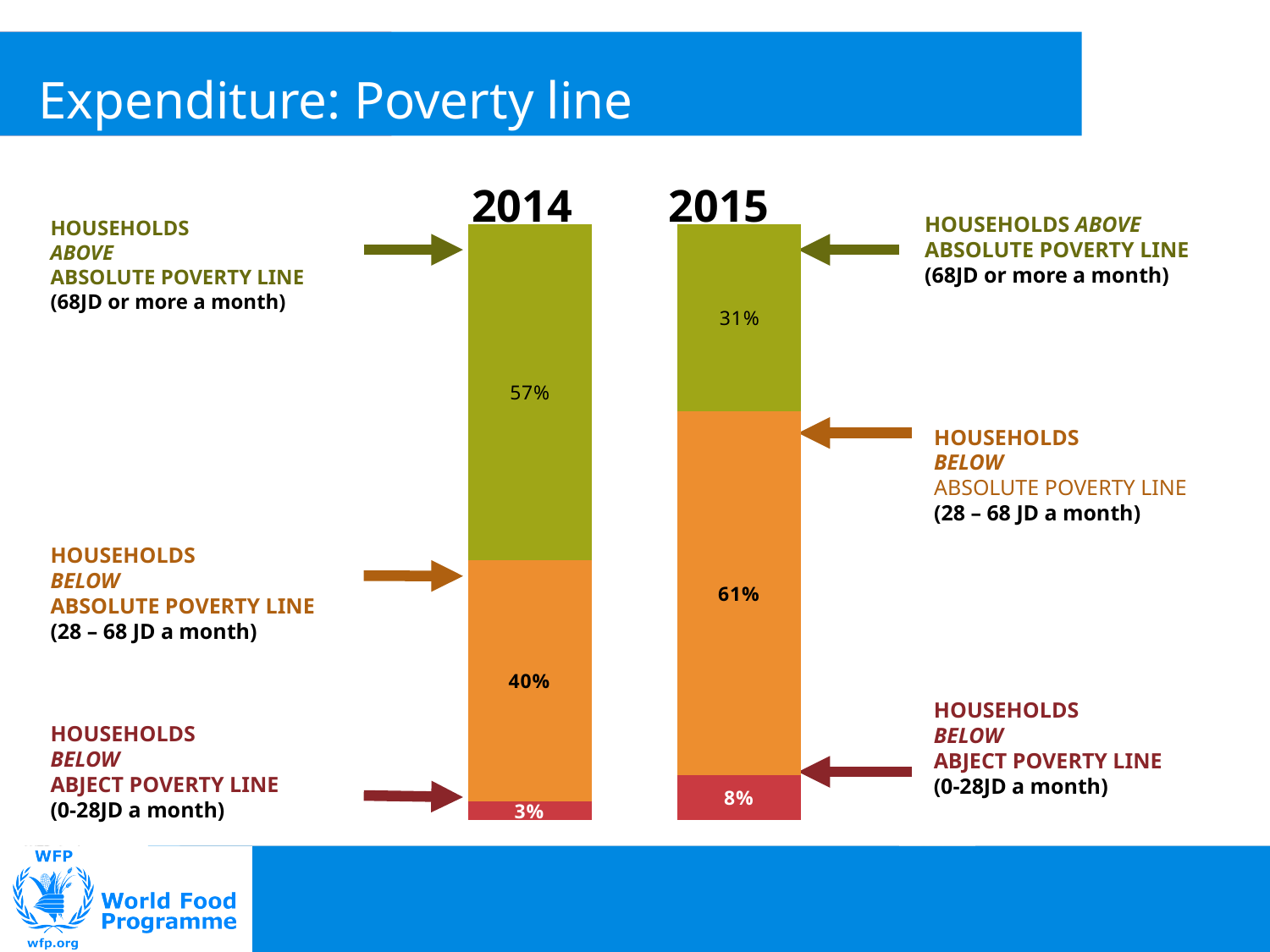
Which segment is the smallest in the 2015 bar? Households below abject poverty line (8%) What percentage of households were above the absolute poverty line in 2015? 31% What percentage of households were below the abject poverty line in 2014? 3% What percentage of households were below the absolute poverty line (28 – 68 JD a month) in 2015? 61% How many years (bars) are shown in the chart? 2 By how many percentage points did the share of households below the abject poverty line change from 2014 to 2015? 5 percentage points Which year had the larger share of households below the absolute poverty line (28 – 68 JD a month)? 2015 By how many percentage points did the share of households above the absolute poverty line fall from 2014 to 2015? 26 percentage points What kind of chart is shown on the slide? Stacked bar chart Which segment is the largest in the 2014 bar? Households above absolute poverty line (57%) What percentage of households were below the abject poverty line in 2015? 8% What percentage of households were above the absolute poverty line in 2014? 57%